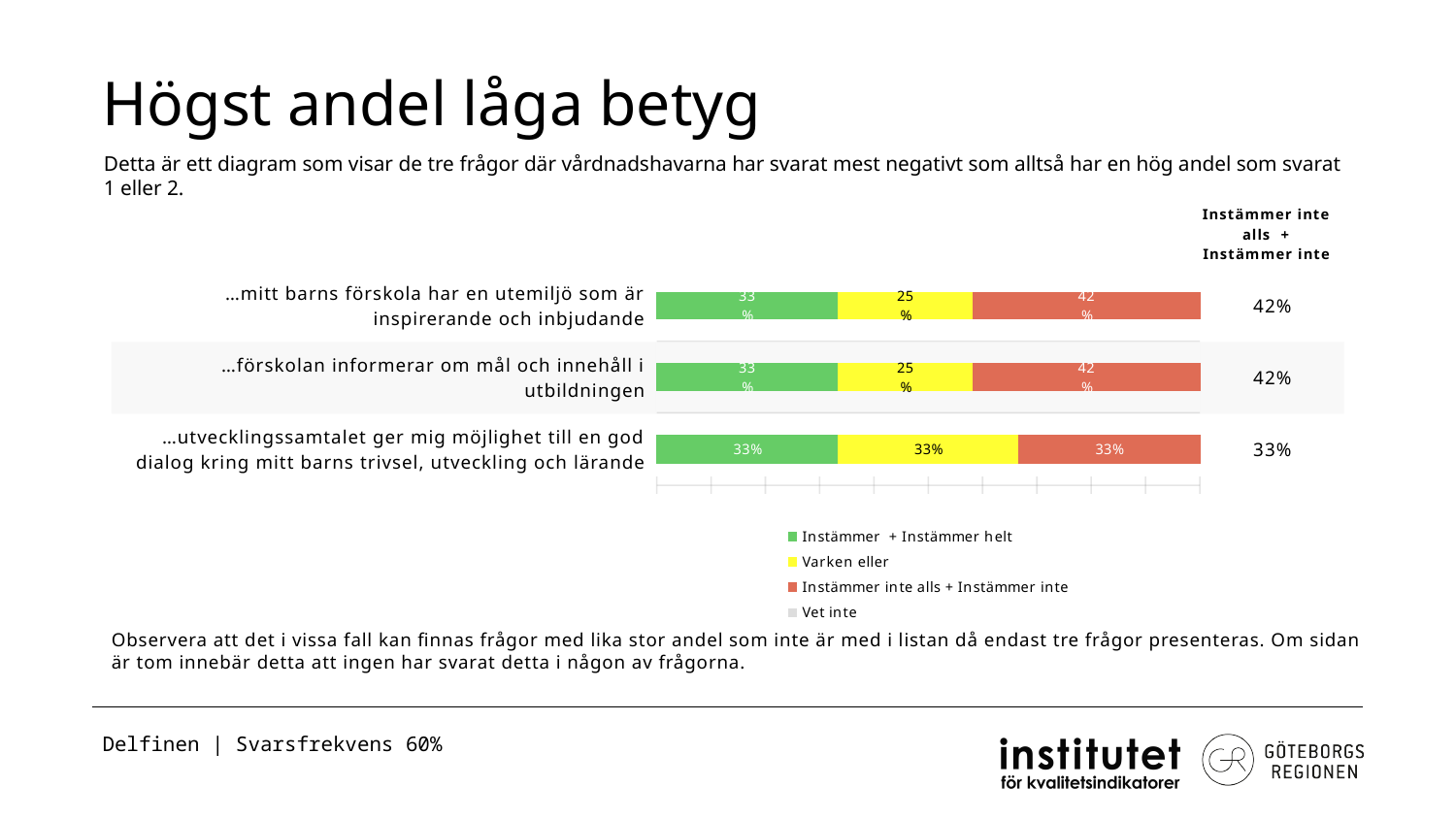
What is the value of "Instämmer inte alls + Instämmer inte" for "…mitt barns förskola har en utemiljö som är inspirerande och inbjudande"? 42% For "…mitt barns förskola har en utemiljö som är inspirerande och inbjudande", which is larger: "Varken eller" or "Instämmer inte alls + Instämmer inte"? Instämmer inte alls + Instämmer inte Which question has the lowest share of "Instämmer inte alls + Instämmer inte"? …utvecklingssamtalet ger mig möjlighet till en god dialog kring mitt barns trivsel, utveckling och lärande What is the total of the three labelled segments for "…förskolan informerar om mål och innehåll i utbildningen"? 100% Which colour represents "Varken eller" in the legend? yellow What is the value of "Instämmer + Instämmer helt" for "…utvecklingssamtalet ger mig möjlighet till en god dialog kring mitt barns trivsel, utveckling och lärande"? 33% What is the difference between the "Instämmer inte alls + Instämmer inte" value for "…förskolan informerar om mål och innehåll i utbildningen" and for "…utvecklingssamtalet ger mig möjlighet till en god dialog kring mitt barns trivsel, utveckling och lärande"? 9% How many questions (categories) are plotted in the chart? 3 What is the value of "Instämmer inte alls + Instämmer inte" for "…utvecklingssamtalet ger mig möjlighet till en god dialog kring mitt barns trivsel, utveckling och lärande"? 33% What is the value of "Varken eller" for "…förskolan informerar om mål och innehåll i utbildningen"? 25% How many series does the legend list? 4 What kind of chart is shown on the slide? stacked bar chart